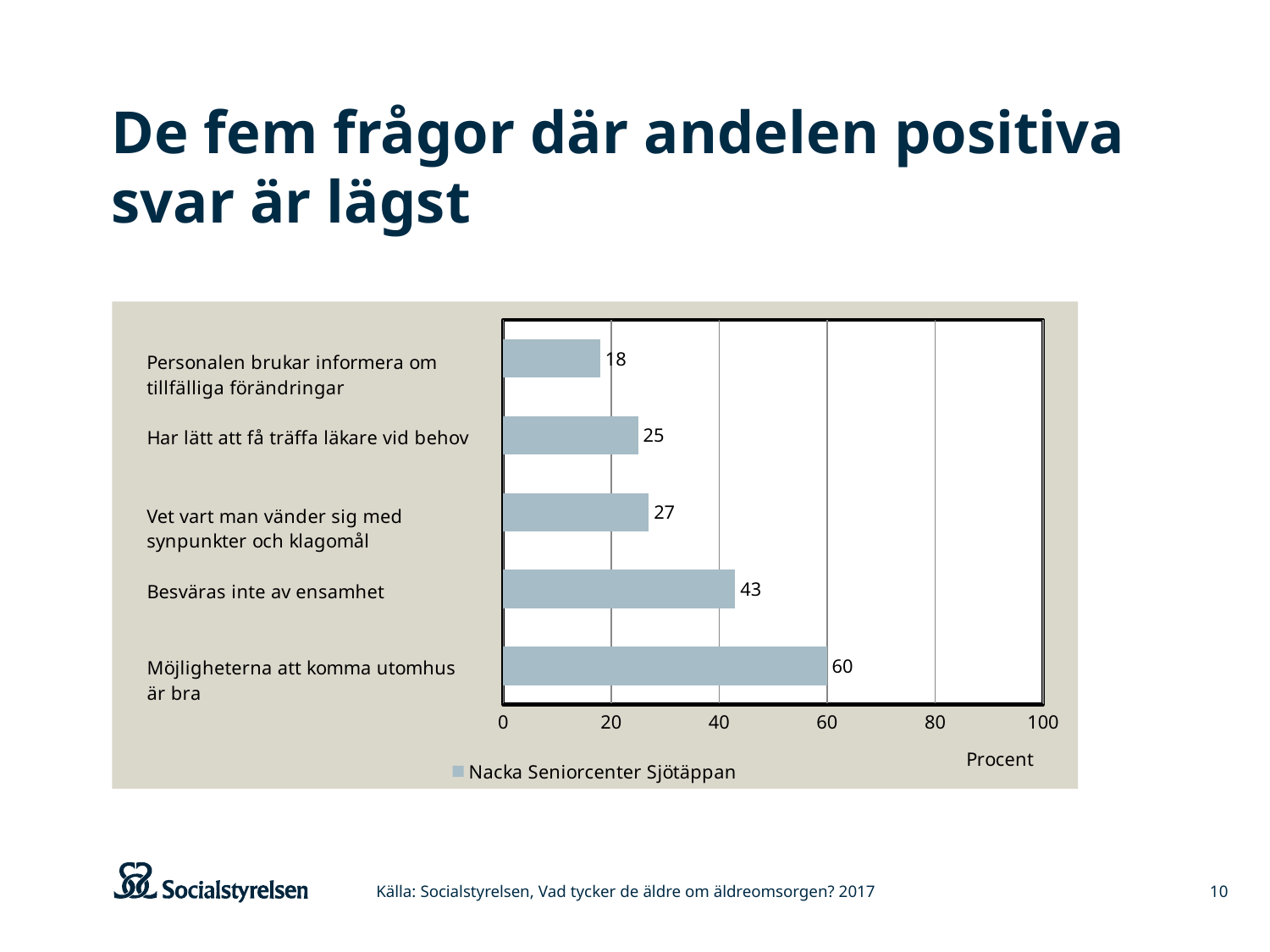
Which is larger: the value for "Vet vart man vänder sig med synpunkter och klagomål" or the value for "Har lätt att få träffa läkare vid behov"? Vet vart man vänder sig med synpunkter och klagomål What is the value for "Har lätt att få träffa läkare vid behov"? 25 Which category has the lowest value? Personalen brukar informera om tillfälliga förändringar What is the name of the series in the legend? Nacka Seniorcenter Sjötäppan How many series does the legend list? 1 What is the value for "Personalen brukar informera om tillfälliga förändringar"? 18 What is the difference between the values for "Möjligheterna att komma utomhus är bra" and "Besväras inte av ensamhet"? 17 What kind of chart is shown on the slide? Bar chart Which category has the highest value? Möjligheterna att komma utomhus är bra What is the value for "Besväras inte av ensamhet"? 43 Is the value for "Besväras inte av ensamhet" greater or less than 40? greater How many categories are shown in the chart? 5